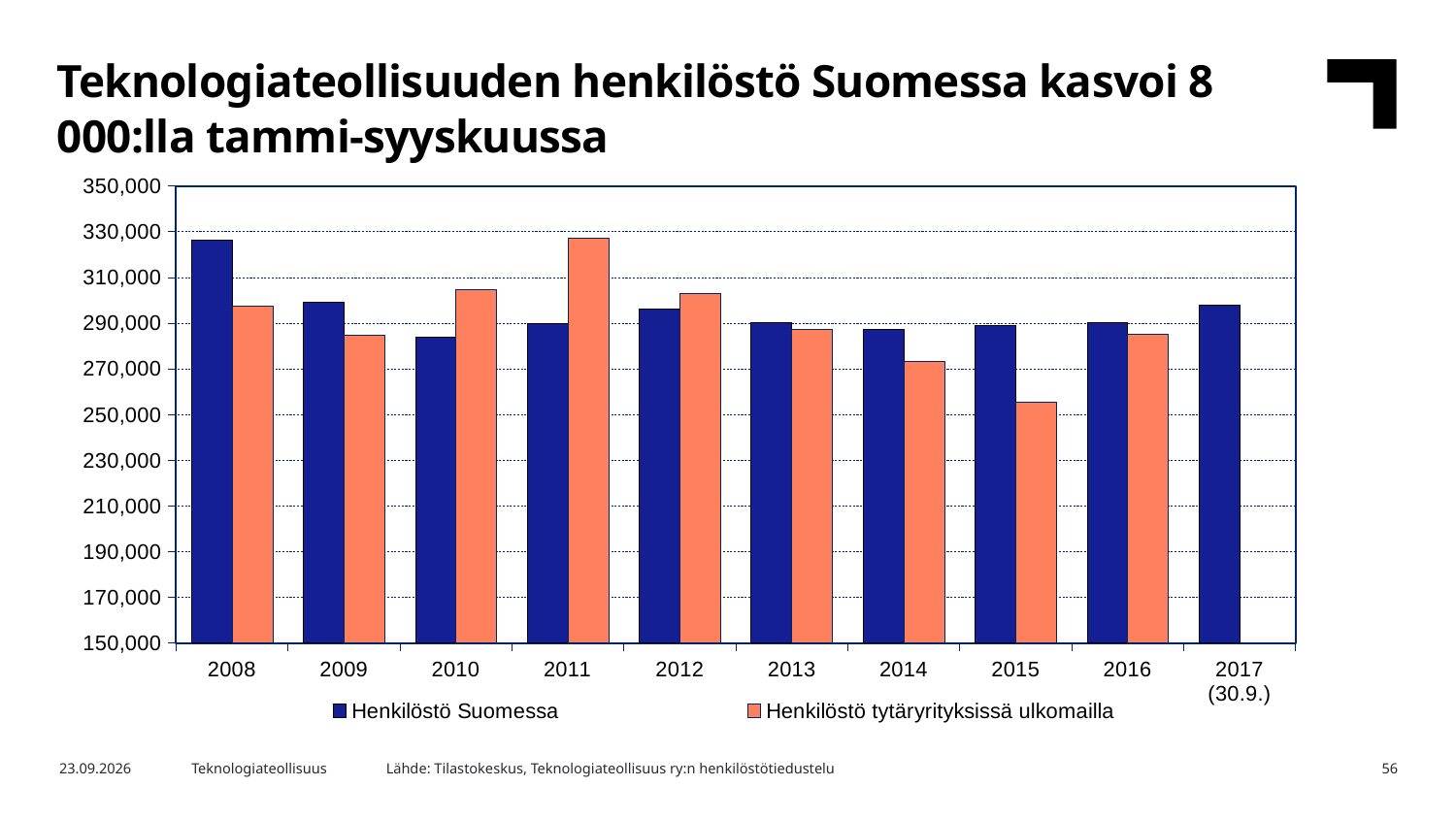
Do the values for Henkilöstö tytäryrityksissä ulkomailla rise or fall from 2011 to 2015? fall Is the value for Henkilöstö tytäryrityksissä ulkomailla in 2014 greater or less than 290,000? less How many series does the legend list? 2 How many years are shown on the x axis? 10 In which year is the value for Henkilöstö tytäryrityksissä ulkomailla highest? 2011 In 2011, which is larger: Henkilöstö Suomessa or Henkilöstö tytäryrityksissä ulkomailla? Henkilöstö tytäryrityksissä ulkomailla Is the value for Henkilöstö Suomessa in 2008 greater or less than 310,000? greater In which year is the value for Henkilöstö Suomessa highest? 2008 In 2015, which is larger: Henkilöstö Suomessa or Henkilöstö tytäryrityksissä ulkomailla? Henkilöstö Suomessa Is the value for Henkilöstö tytäryrityksissä ulkomailla in 2015 greater or less than 270,000? less In which year is the value for Henkilöstö tytäryrityksissä ulkomailla lowest? 2015 What kind of chart is shown on the slide? bar chart